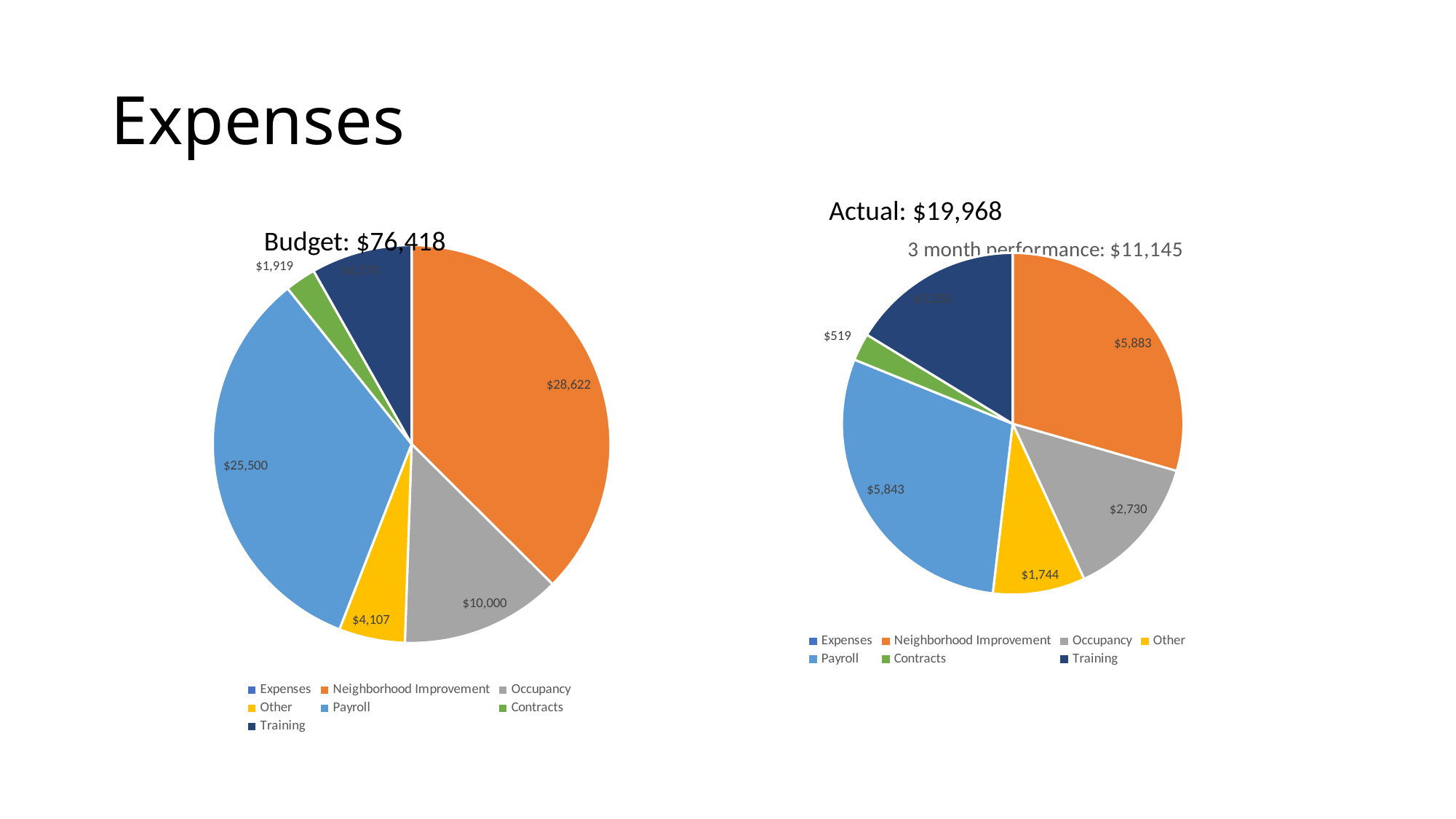
In the right pie chart (3 month performance: $11,145), what is the difference between Occupancy and Other? $986 In the left pie chart (Budget: $76,418), what is the value for Payroll? $25,500 In the right pie chart (3 month performance: $11,145), which category has the smallest slice? Contracts In the right pie chart (3 month performance: $11,145), what is the value for Occupancy? $2,730 In the left pie chart (Budget: $76,418), how much larger is Neighborhood Improvement than Payroll? $3,122 In the right pie chart (3 month performance: $11,145), what is the value for Contracts? $519 In the left pie chart (Budget: $76,418), which category has the largest slice? Neighborhood Improvement In the left pie chart (Budget: $76,418), what is the value for Occupancy? $10,000 In the left pie chart (Budget: $76,418), what is the value for Neighborhood Improvement? $28,622 What kind of chart is the left chart on the slide? Pie chart In the left pie chart (Budget: $76,418), which category has the smallest slice? Contracts In the left pie chart (Budget: $76,418), which is larger, Occupancy or Other? Occupancy